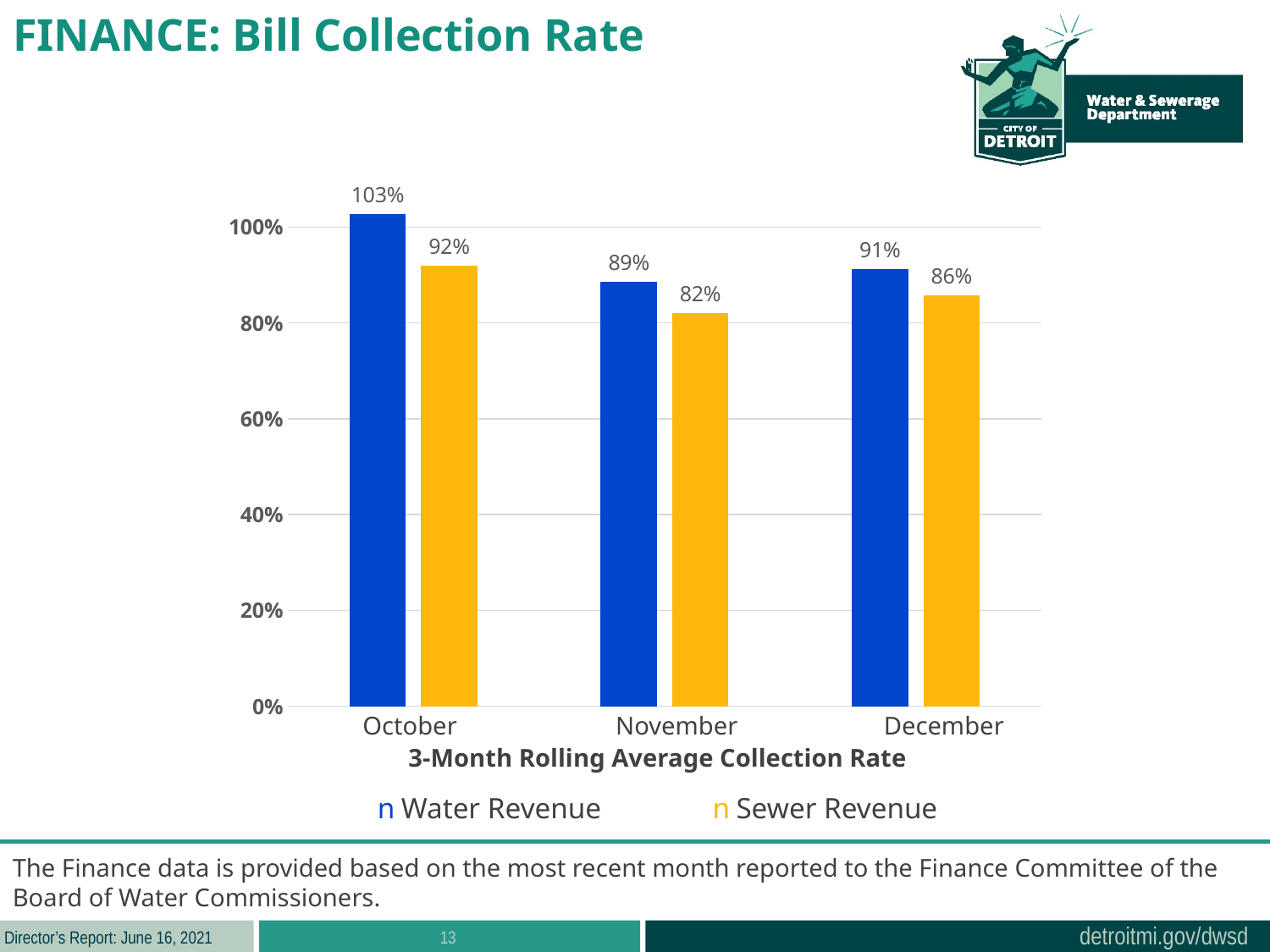
What is the difference between the Water Revenue and Sewer Revenue collection rates in December? 5% What is the Water Revenue collection rate for December? 91% What is the Sewer Revenue collection rate for October? 92% What is the Sewer Revenue collection rate for November? 82% What is the Water Revenue collection rate for October? 103% What is the x-axis title of the chart? 3-Month Rolling Average Collection Rate Which month has the lowest Sewer Revenue collection rate? November Which is larger in November, the Water Revenue or the Sewer Revenue collection rate? Water Revenue How many months are shown on the x axis? 3 How many series does the legend list? 2 Which month has the highest Water Revenue collection rate? October What kind of chart is shown on the slide? Bar chart